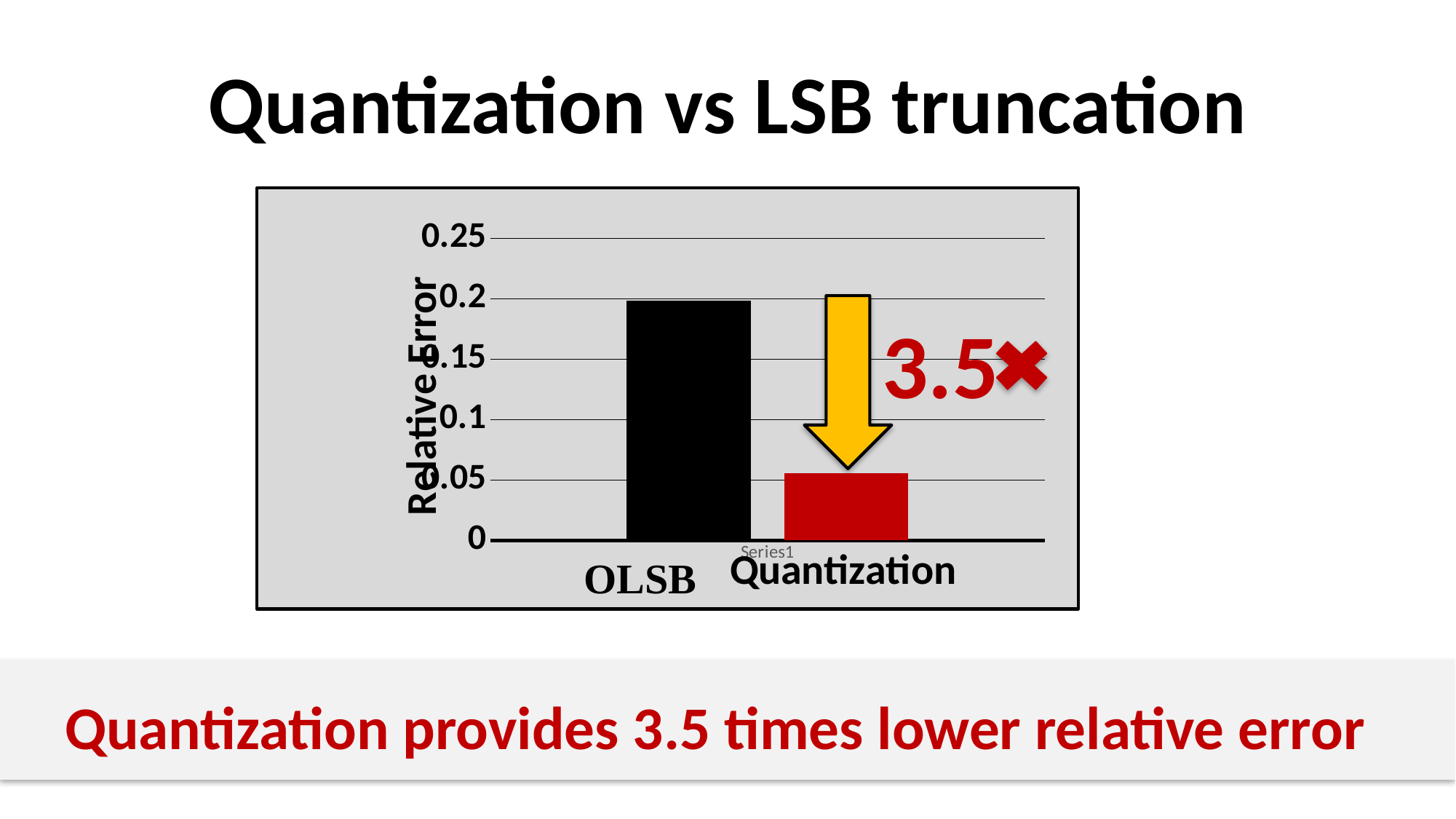
Do the bar values rise or fall from OLSB to Quantization? fall Which category has the highest relative error? OLSB Is the relative error for OLSB greater or less than 0.25? less Is the relative error for Quantization greater or less than 0.1? less Which has a larger relative error, OLSB or Quantization? OLSB Is the relative error for OLSB greater or less than 0.15? greater How many bars are plotted in the chart? 2 Which category has the lowest relative error? Quantization What colour is the bar for Quantization? red What kind of chart is shown on the slide? bar chart What is the label on the vertical axis of the chart? Relative error